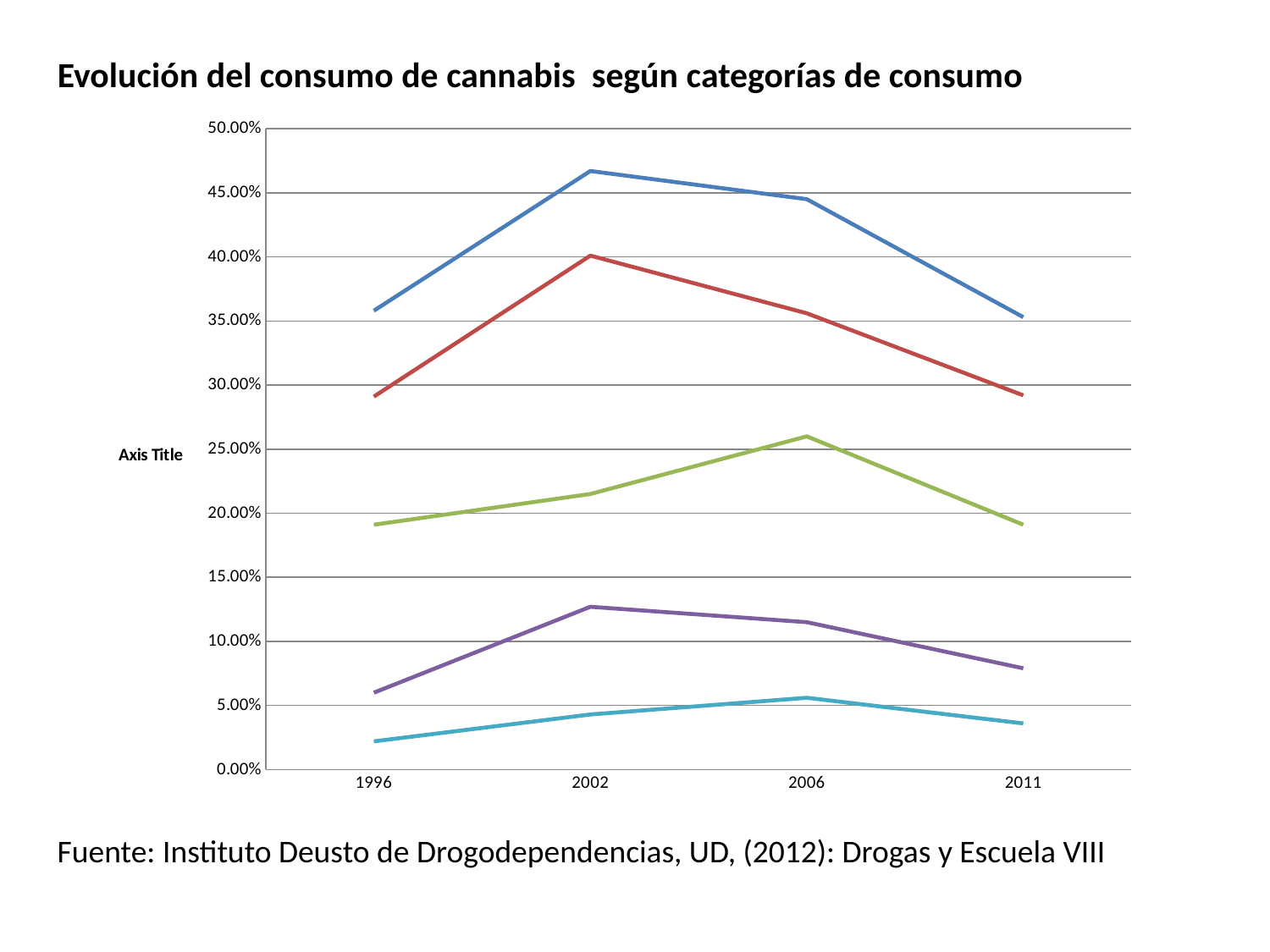
In which year does the purple line reach its lowest value? 1996 Is the value of the dark blue line in 2002 greater or less than 45.00%? greater How many years are shown on the x axis of the chart? 4 How many lines are plotted on the chart? 5 In which year does the green line reach its highest value? 2006 What kind of chart is shown on the slide? line chart What is the title of the chart? Evolución del consumo de cannabis según categorías de consumo Which line has the higher value in 2006, the red line or the green line? the red line Is the value of the light blue line in 1996 greater or less than 5.00%? less In which year does the top (dark blue) line reach its highest value? 2002 Is the value of the purple line in 2002 greater or less than 10.00%? greater Does the dark blue line rise or fall between 2002 and 2011? fall